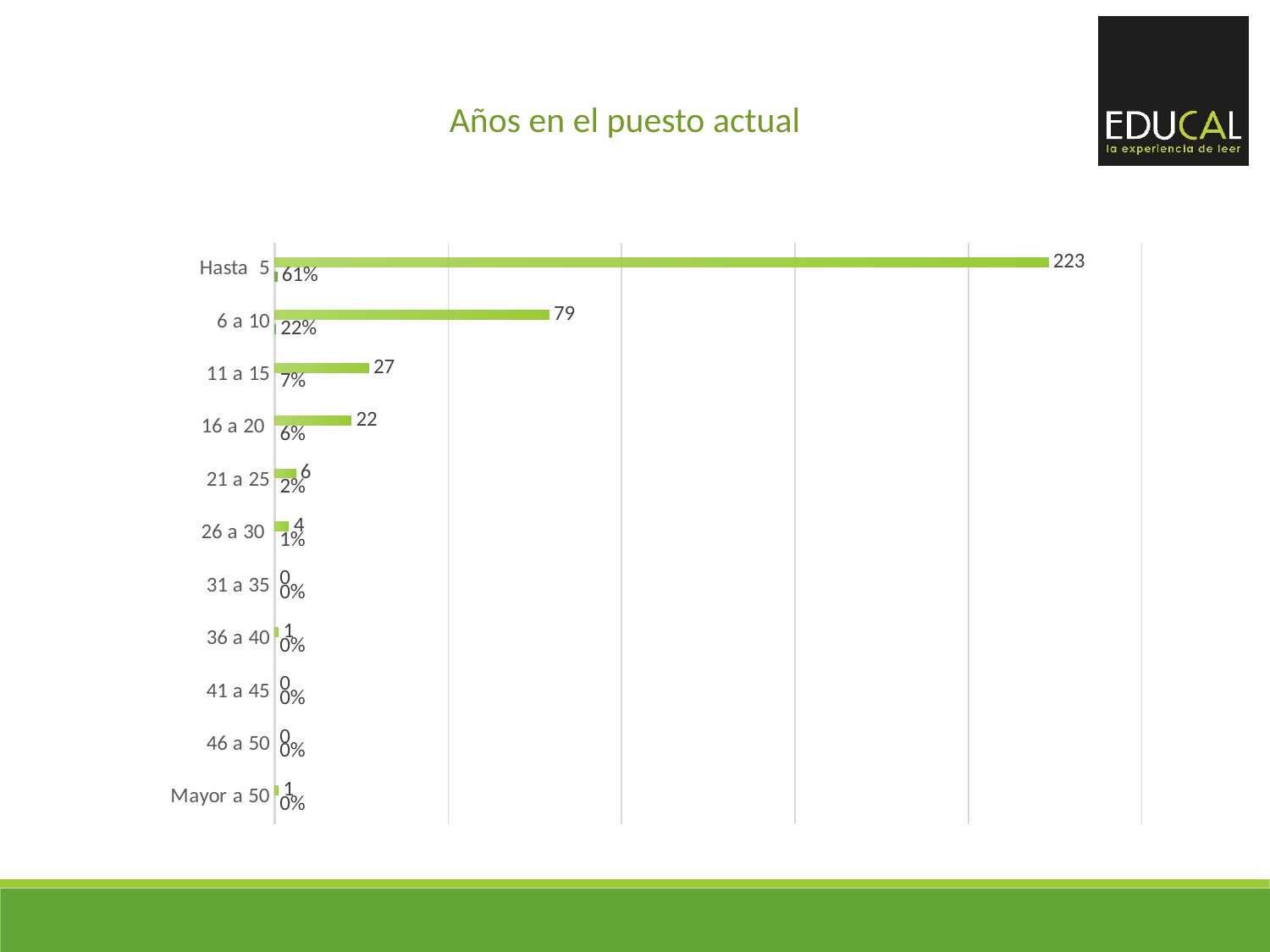
What is the title of the chart? Años en el puesto actual What is the difference between the counts for 'Hasta 5' and '6 a 10'? 144 What is the count value for the 'Mayor a 50' category? 1 What is the difference between the counts for '11 a 15' and '16 a 20'? 5 What kind of chart is shown on the slide? Bar chart Which category has the highest count? Hasta 5 What percentage is shown for the '11 a 15' category? 7% What is the count value for the '16 a 20' category? 22 What is the count value for the '6 a 10' category? 79 What percentage is shown for the 'Hasta 5' category? 61% How many categories are shown on the chart? 11 Which has a larger count, '21 a 25' or '26 a 30'? 21 a 25